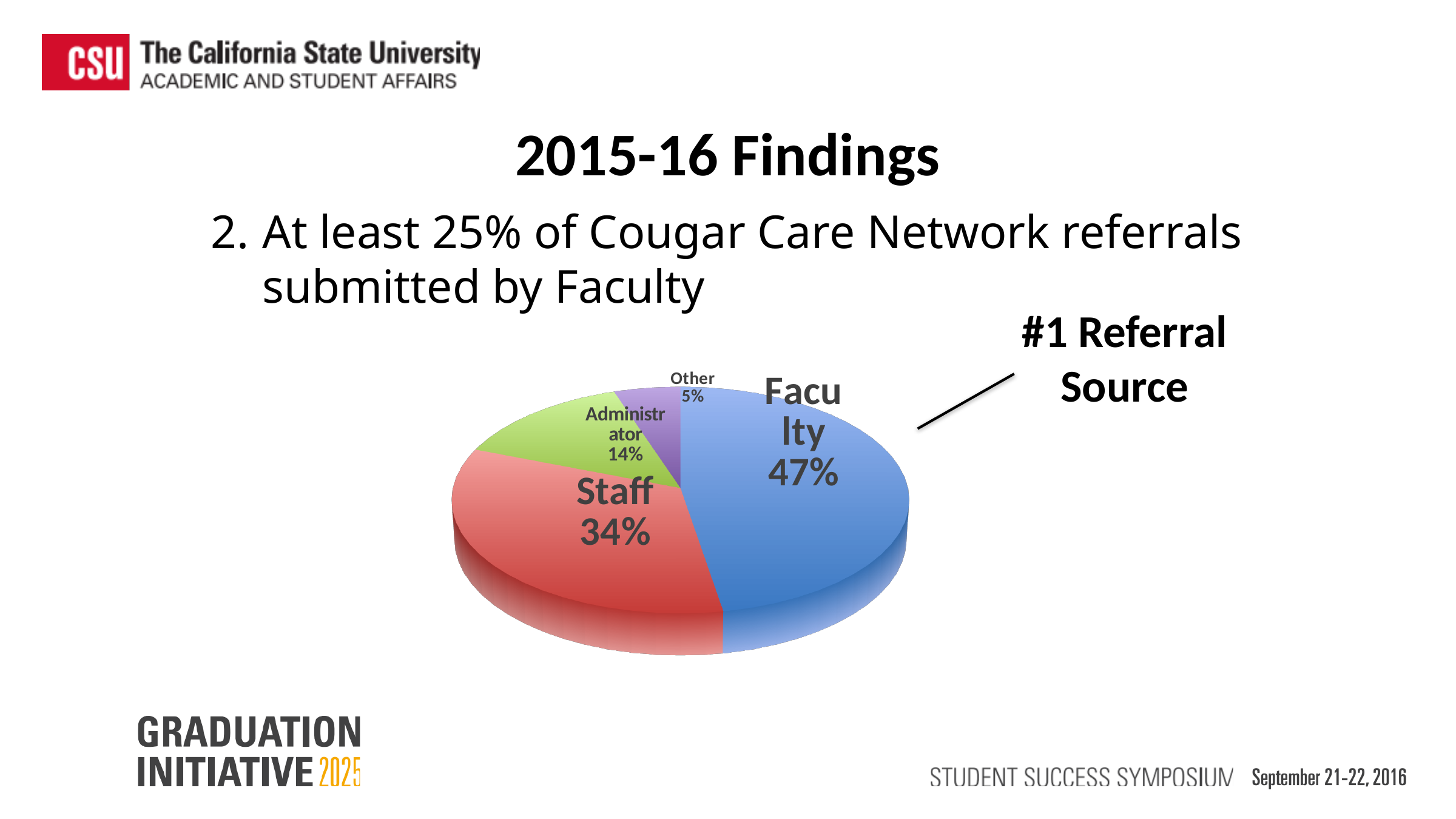
What is the difference in percentage points between the Faculty and Staff slices? 13 Which slice is labelled as the #1 Referral Source? Faculty What share of referrals came from Faculty? 47% Which is larger, the Administrator slice or the Other slice? Administrator What share of referrals came from Staff? 34% What kind of chart is shown on the slide? Pie chart What is the difference in percentage points between the Staff and Administrator slices? 20 Which referral source has the smallest slice of the pie? Other What share of referrals came from Other? 5% Which referral source has the largest slice of the pie? Faculty How many slices does the pie chart have? 4 What share of referrals came from Administrator? 14%